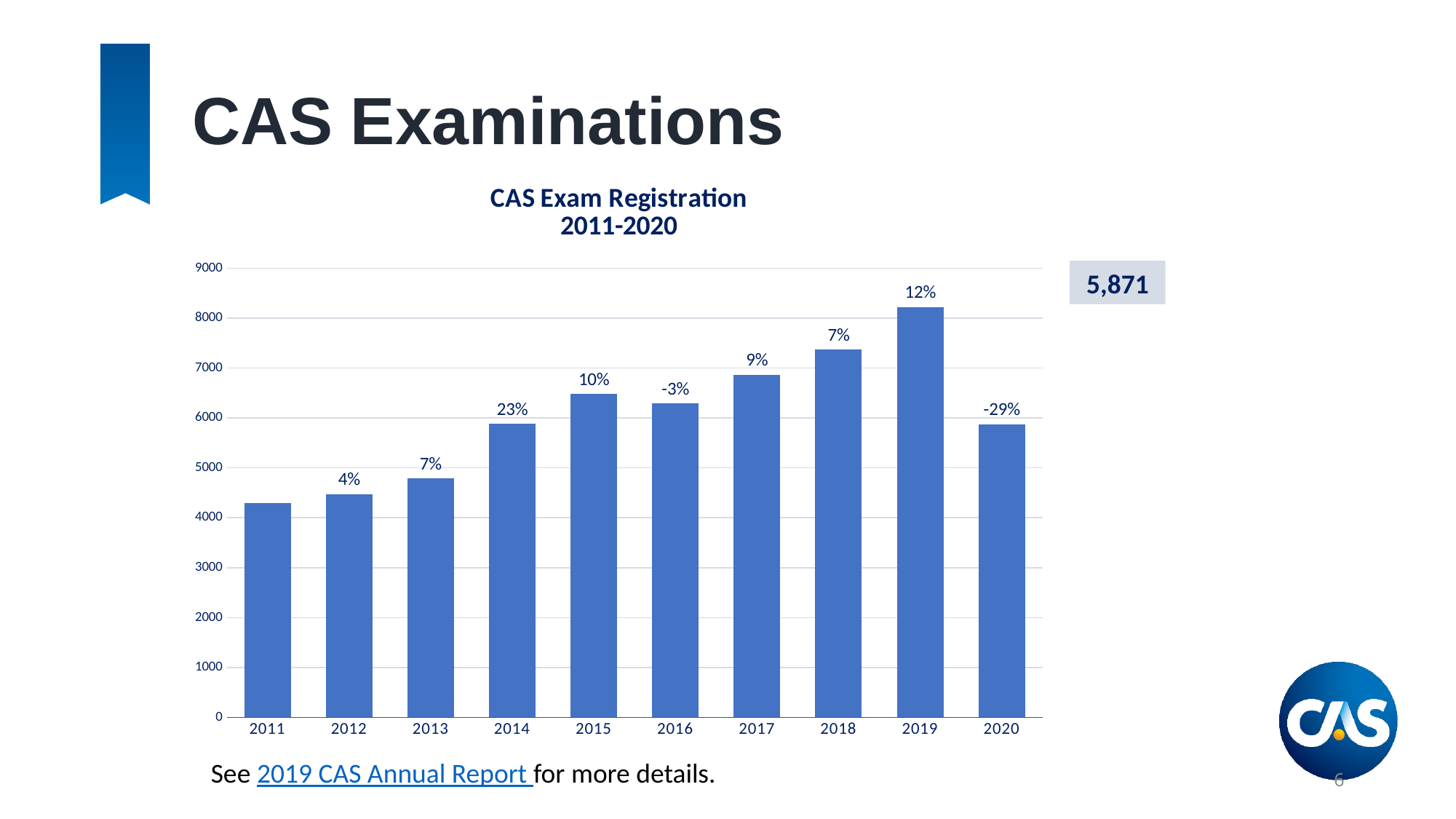
What percentage label is printed above the 2020 bar? -29% What kind of chart is shown on the slide? bar chart What is the title of the chart? CAS Exam Registration 2011-2020 What percentage label is printed above the 2014 bar? 23% Which year has the lowest exam registration bar? 2011 Do the bars generally rise or fall from 2011 to 2019? rise Which year has the highest exam registration bar? 2019 Is the value for 2020 greater or less than 6000? less What percentage label is printed above the 2016 bar? -3% Which year has the taller bar, 2017 or 2018? 2018 Is the value for 2019 greater or less than 8000? greater How many years (bars) are plotted in the CAS Exam Registration chart? 10